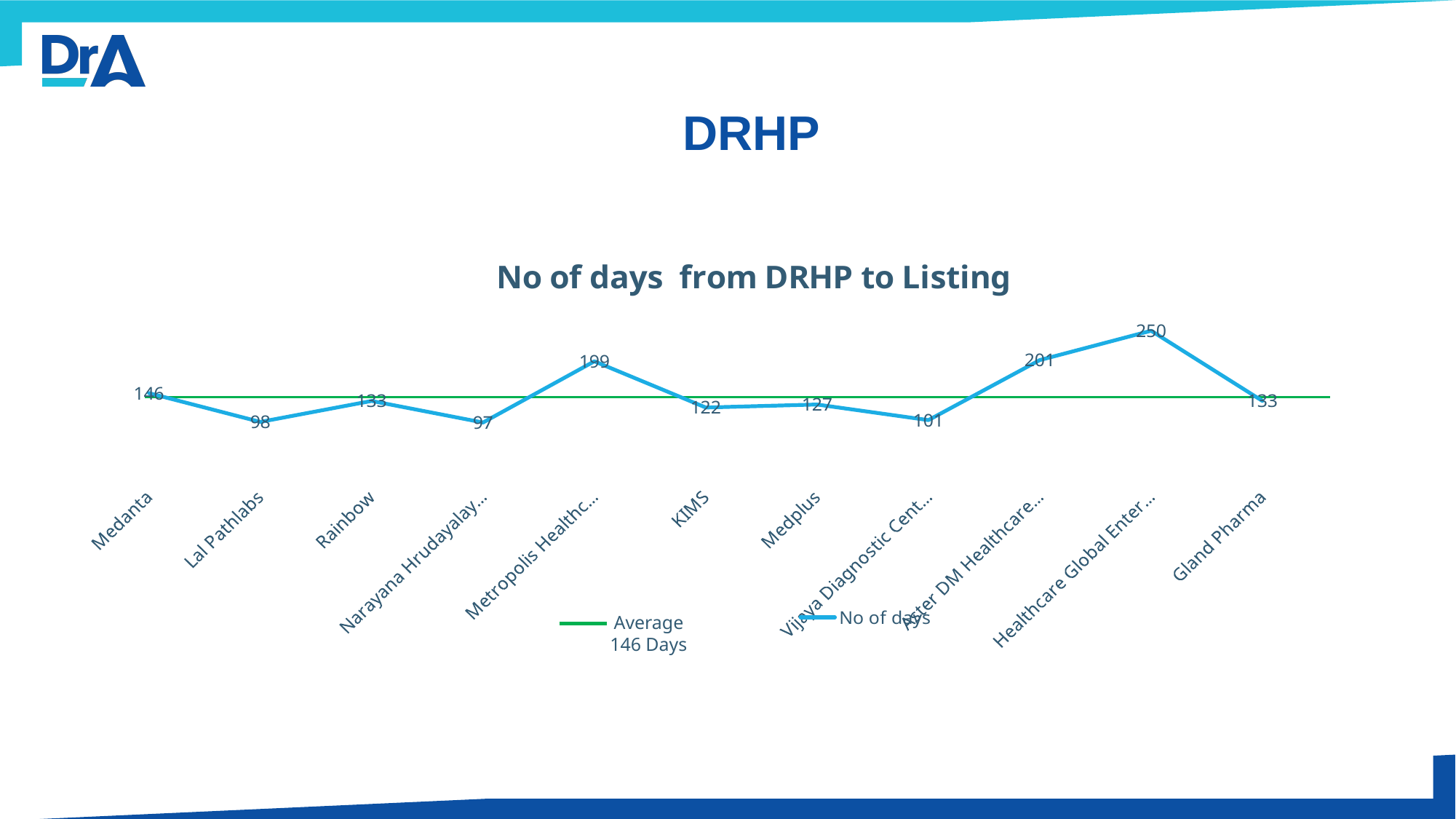
What is the difference in days between Medplus and KIMS? 5 What type of chart is shown on the slide? Line chart Which company has the highest number of days from DRHP to listing? Healthcare Global Enter... What is the number of days for Lal Pathlabs? 98 How many companies are plotted on the chart? 11 What is the number of days for KIMS? 122 What is the title of the chart? No of days from DRHP to Listing Which has more days from DRHP to listing, Rainbow or Lal Pathlabs? Rainbow How many series does the legend list? 2 What value does the green average line represent? 146 Days What is the number of days for Gland Pharma? 133 How many days from DRHP to listing are shown for Medanta? 146